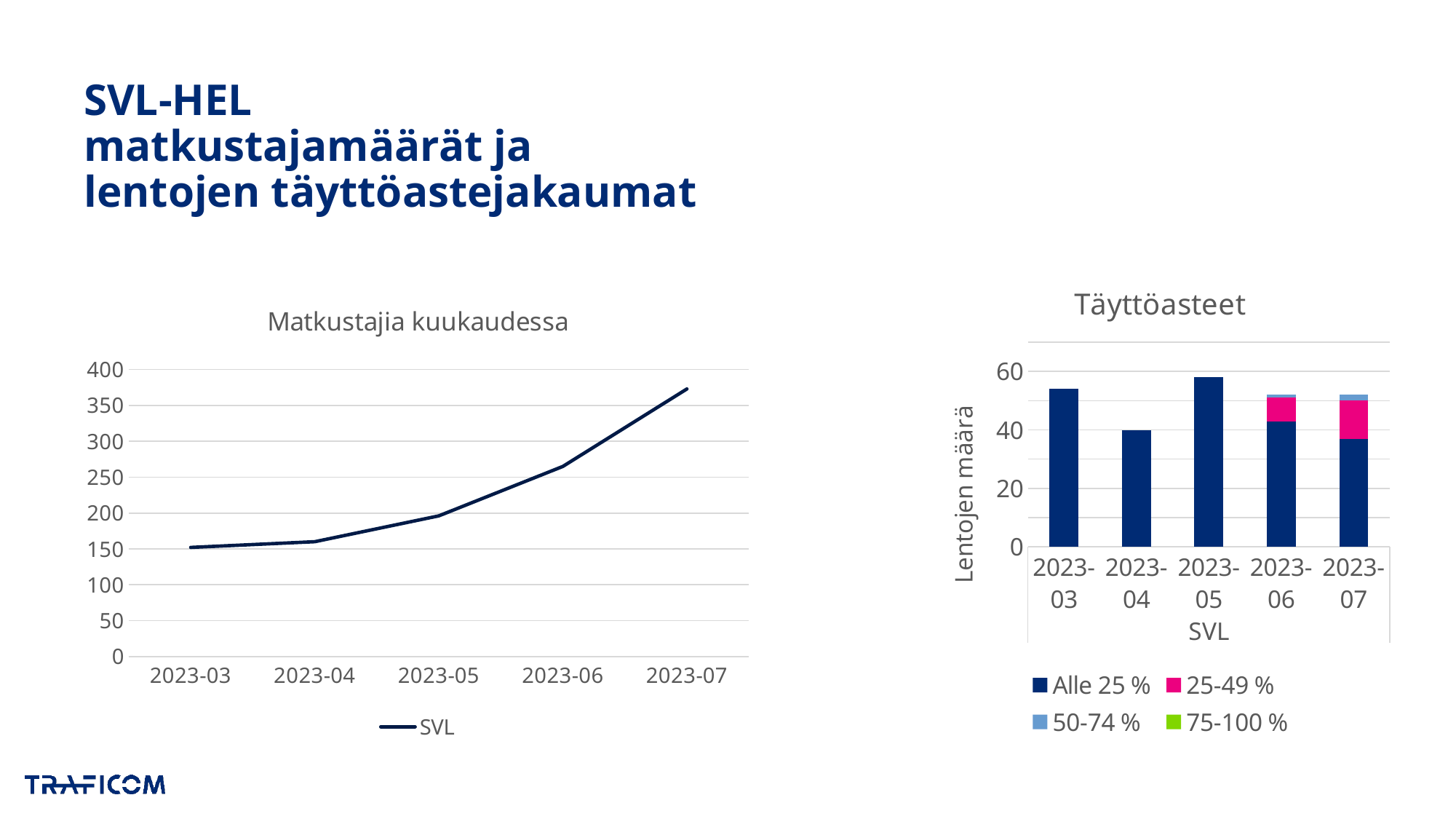
In the 'Täyttöasteet' chart, which month has the lowest total bar? 2023-04 What type of chart is the 'Matkustajia kuukaudessa' chart? line chart In the 'Matkustajia kuukaudessa' chart, is the value for 2023-07 greater or less than 350? greater What type of chart is the 'Täyttöasteet' chart? bar chart In the 'Täyttöasteet' chart, is the 'Alle 25 %' value for 2023-07 greater or less than 40? less In the 'Matkustajia kuukaudessa' chart, which month has the lowest value? 2023-03 In the 'Matkustajia kuukaudessa' chart, is the value for 2023-04 greater or less than 200? less How many months are shown on the x axis of the 'Täyttöasteet' chart? 5 In the 'Matkustajia kuukaudessa' chart, do the values rise or fall from 2023-03 to 2023-07? rise How many series does the legend of the 'Täyttöasteet' chart list? 4 In the 'Matkustajia kuukaudessa' chart, which month has the highest value? 2023-07